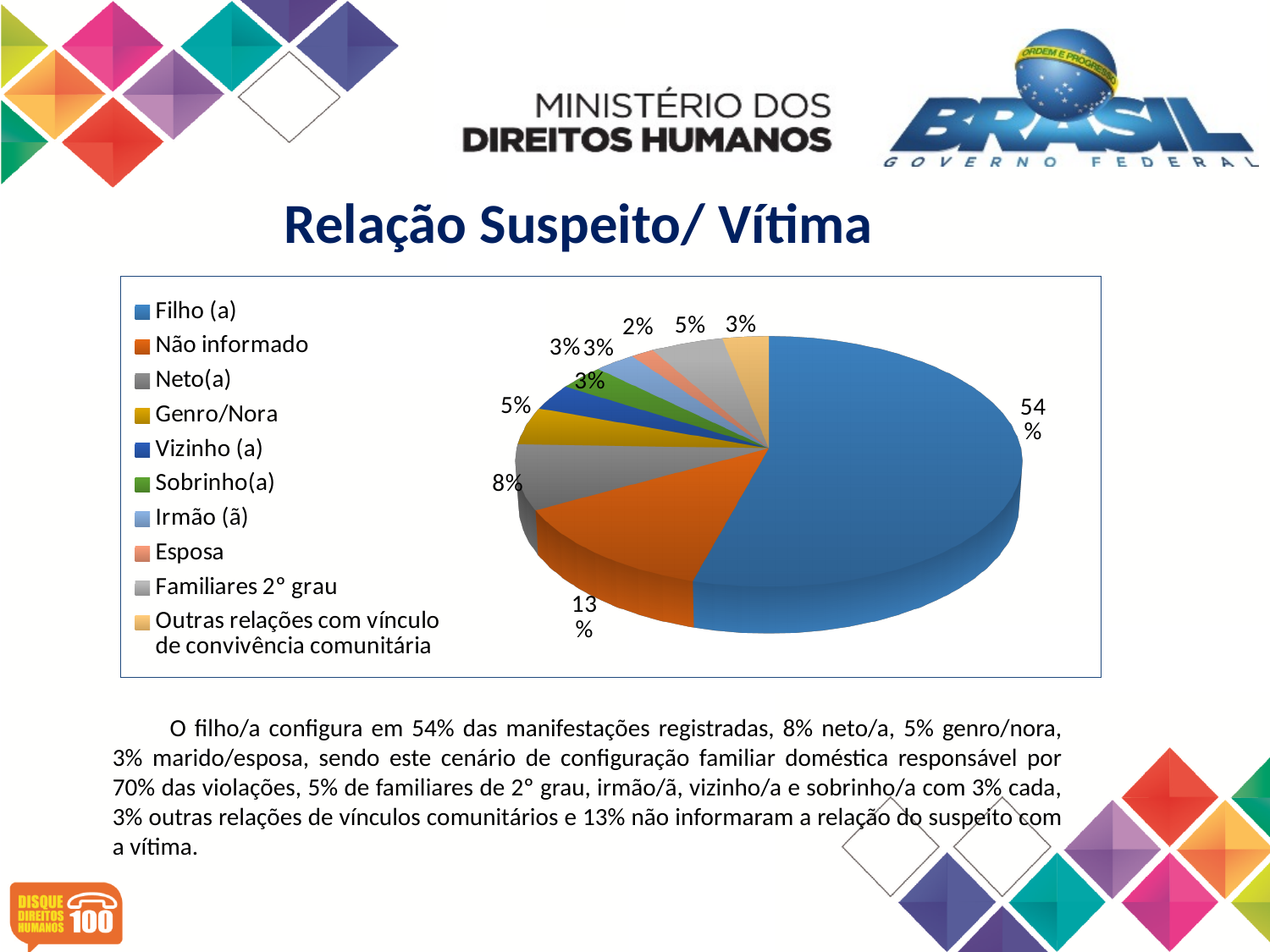
Which is larger, the share for Neto(a) or the share for Genro/Nora? Neto(a) What is the value shown for Familiares 2° grau? 5% How many categories does the legend of the pie chart list? 10 What is the value shown for Não informado? 13% What is the difference between the shares of Filho (a) and Não informado? 41 percentage points What is the value shown for Neto(a)? 8% Which category has the largest slice of the pie? Filho (a) What share of the pie does Filho (a) represent? 54% What kind of chart is shown on the slide? pie chart What is the value shown for Outras relações com vínculo de convivência comunitária? 3% What is the value shown for Genro/Nora? 5% What is the title of the chart? Relação Suspeito/ Vítima